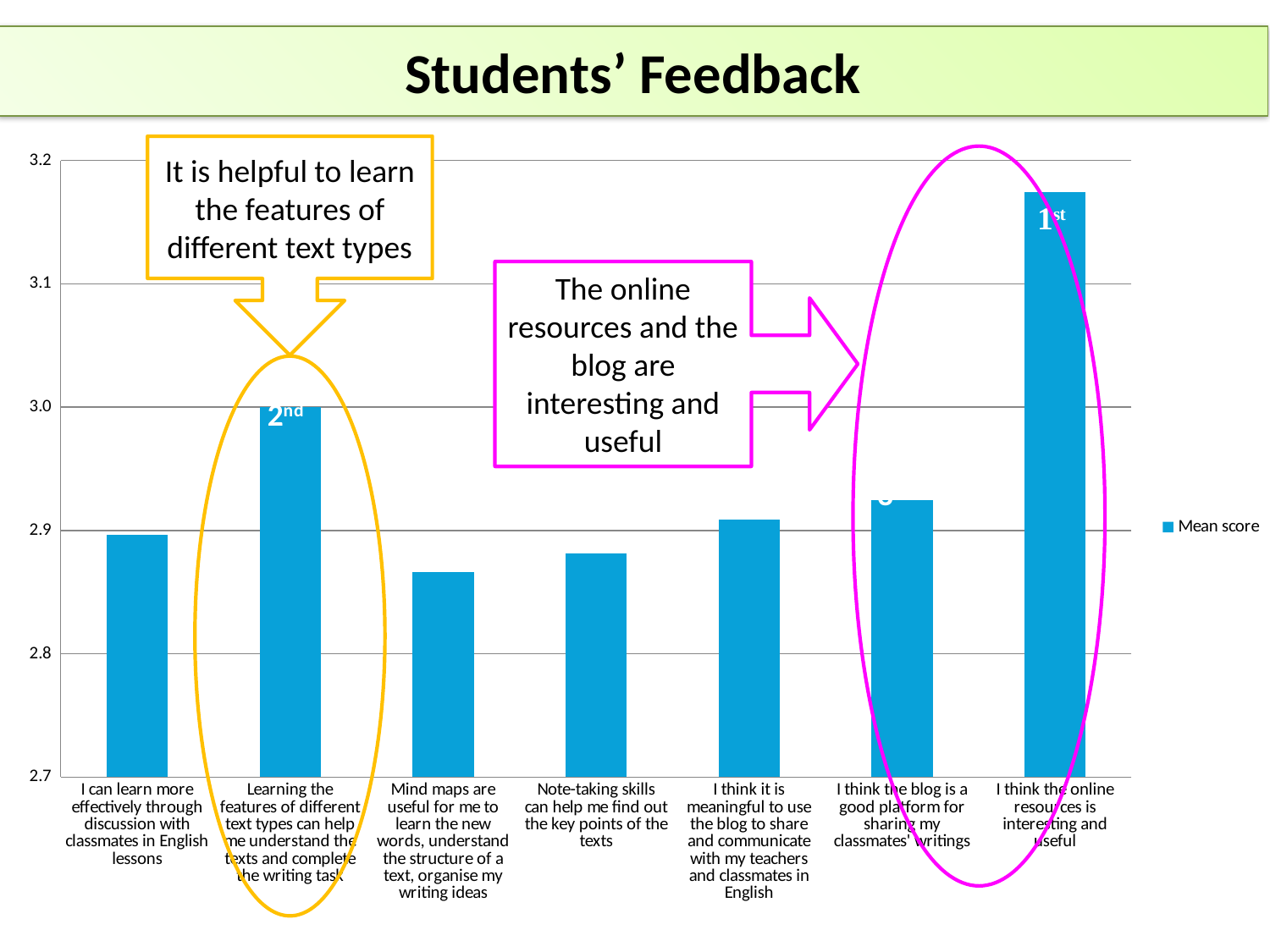
Which has the higher mean score: 'Learning the features of different text types can help me understand the texts and complete the writing task' or 'I think it is meaningful to use the blog to share and communicate with my teachers and classmates in English'? Learning the features of different text types can help me understand the texts and complete the writing task What kind of chart is shown on the slide? Bar chart How many categories (bars) does the chart show? 7 Which category has the highest mean score? I think the online resources is interesting and useful Is the mean score for 'Note-taking skills can help me find out the key points of the texts' greater or less than 2.9? less Is the mean score for 'I think the blog is a good platform for sharing my classmates' writings' greater or less than 2.9? greater How many series does the legend list? 1 Which category has the lowest mean score? Mind maps are useful for me to learn the new words, understand the structure of a text, organise my writing ideas Which category's bar is labelled '2nd' on the chart? Learning the features of different text types can help me understand the texts and complete the writing task Is the mean score for 'I think the online resources is interesting and useful' greater or less than 3.1? greater What is the name of the series shown in the legend? Mean score